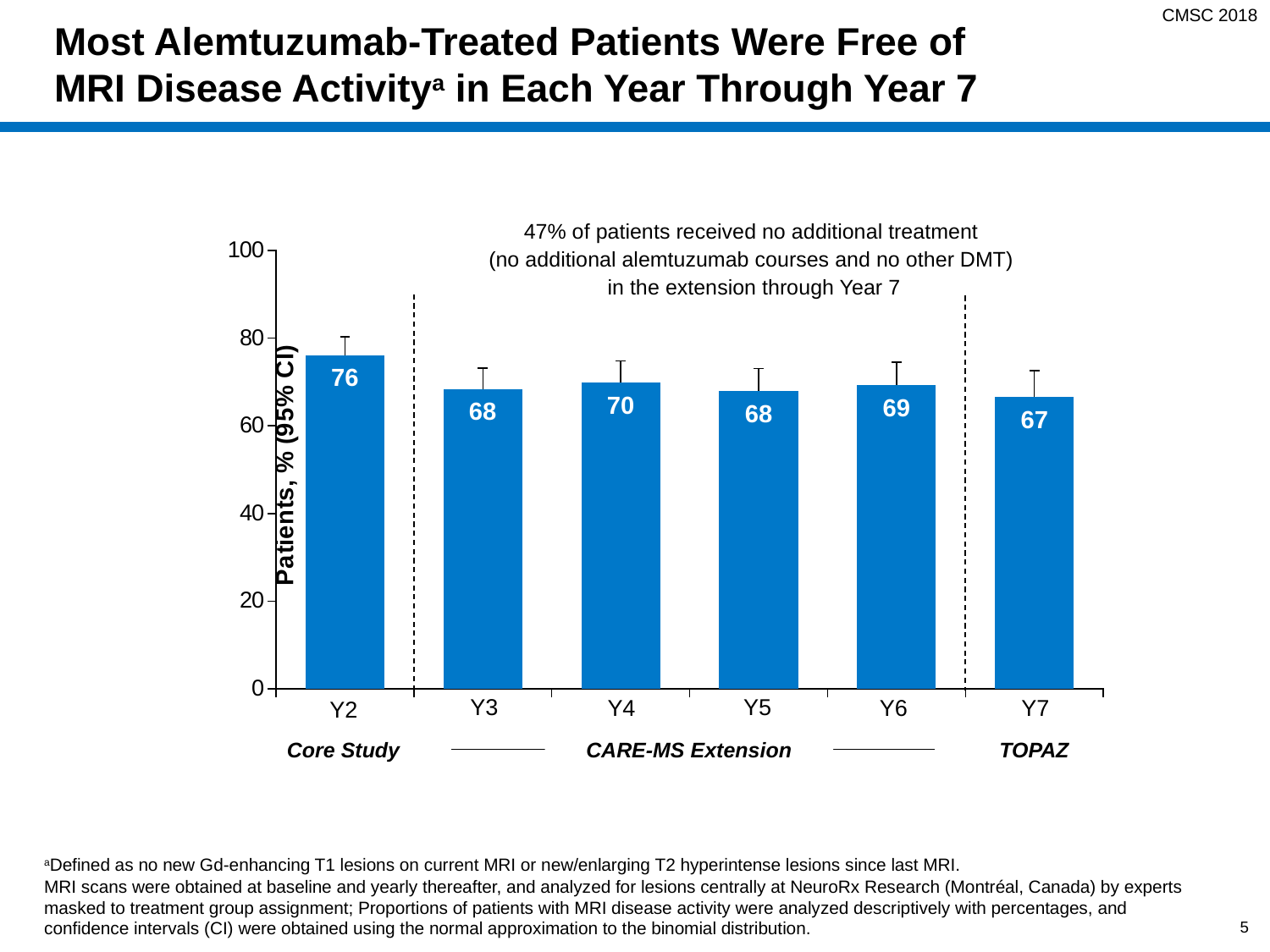
How many years (bars) are shown on the chart? 6 What is the label of the y axis? Patients, % (95% CI) What percentage of patients were free of MRI disease activity in Y2? 76 Is the value for Y2 greater or less than 80? less What kind of chart is shown on the slide? bar chart Which year has the lowest percentage of patients free of MRI disease activity? Y7 Which study period does the Y7 bar belong to? TOPAZ What is the value shown for Y4? 70 What is the difference between the values for Y2 and Y7? 9 What is the value shown for Y7? 67 Which is larger, the value for Y4 or the value for Y6? Y4 Which year has the highest percentage of patients free of MRI disease activity? Y2